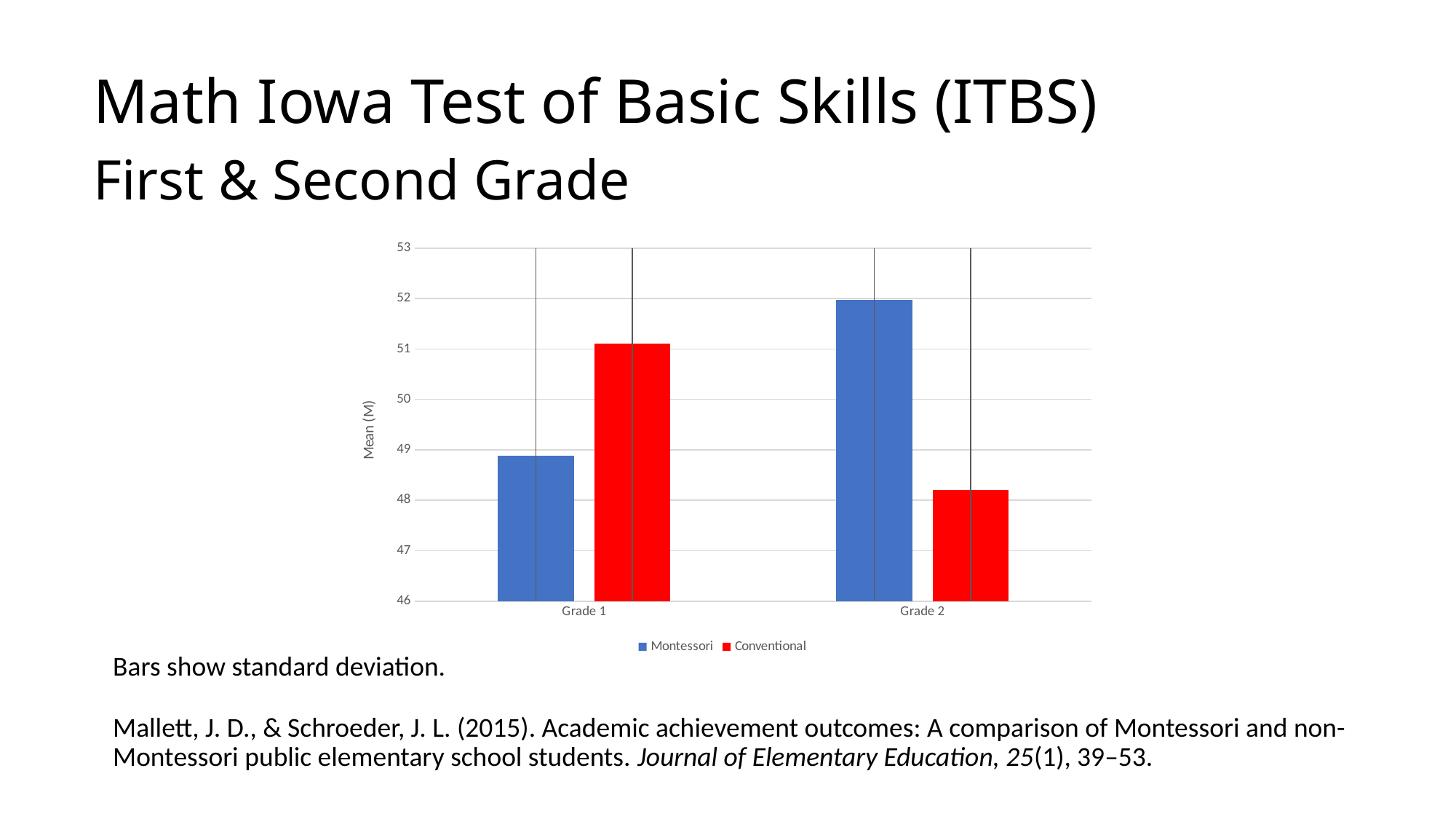
How many series does the legend list? 2 For Grade 1, which is larger, Montessori or Conventional? Conventional Which bar is the lowest in the chart? Conventional, Grade 2 Which series is shown in red? Conventional Is the Montessori value for Grade 1 greater or less than 50? less What kind of chart is shown on the slide? bar chart Is the Montessori value for Grade 2 greater or less than 51? greater Which bar is the highest in the chart? Montessori, Grade 2 What is the label of the y axis? Mean (M) Is the Conventional value for Grade 1 greater or less than 50? greater For Grade 2, which is larger, Montessori or Conventional? Montessori How many grade categories are shown on the x axis? 2